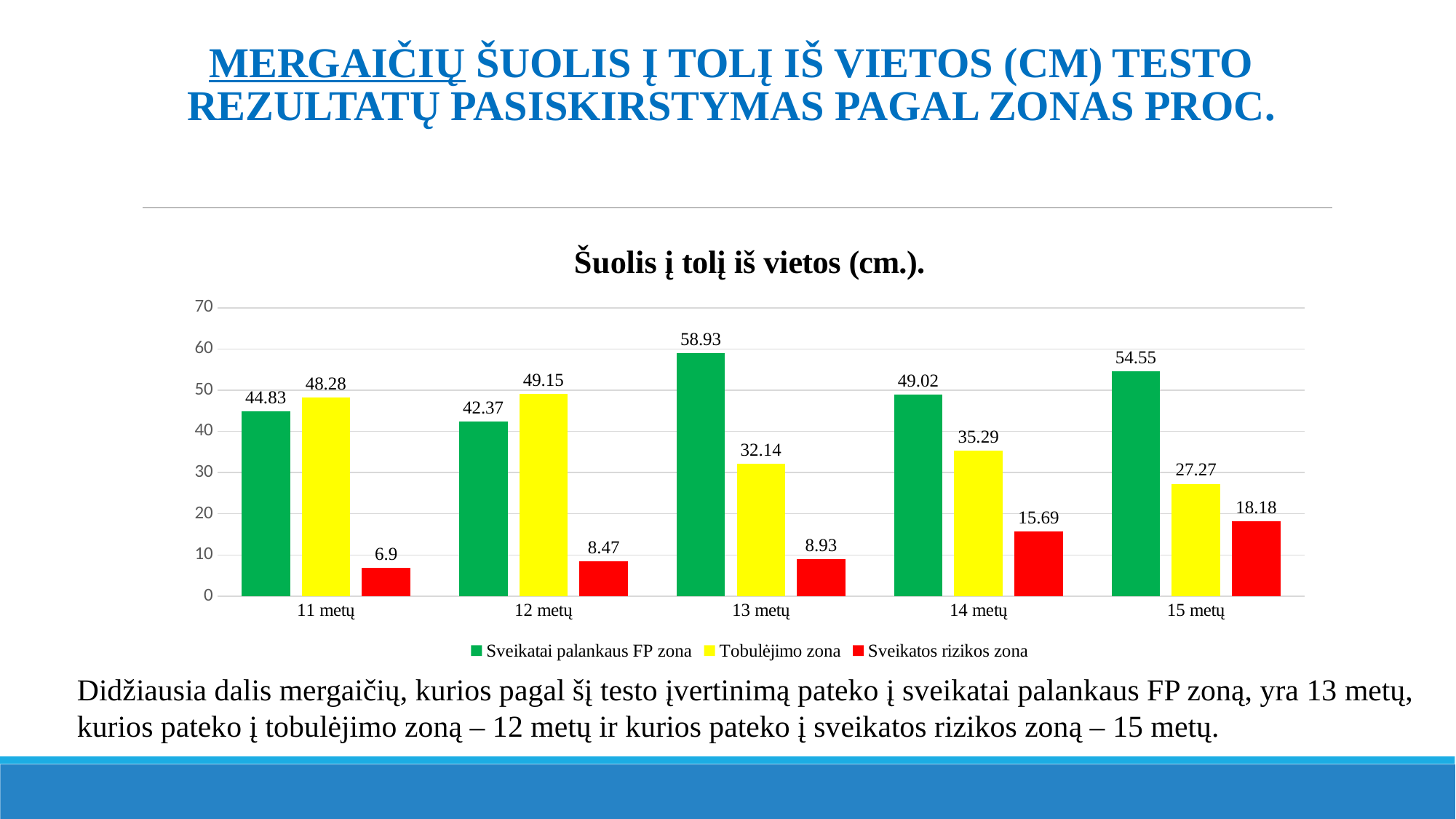
What is the title of the chart? Šuolis į tolį iš vietos (cm.). Which age group has the highest value for Sveikatos rizikos zona? 15 metų What is the value for Tobulėjimo zona at 12 metų? 49.15 What is the value for Sveikatos rizikos zona at 11 metų? 6.9 Which age group has the lowest value for Sveikatos rizikos zona? 11 metų Which age group has the highest value for Sveikatai palankaus FP zona? 13 metų What kind of chart is shown on the slide? Bar chart How many series does the legend list? 3 What is the difference between the Sveikatai palankaus FP zona value and the Tobulėjimo zona value at 15 metų? 27.28 How many age groups are shown on the x axis? 5 Which is larger at 11 metų: Sveikatai palankaus FP zona or Tobulėjimo zona? Tobulėjimo zona What is the value for Sveikatai palankaus FP zona at 13 metų? 58.93